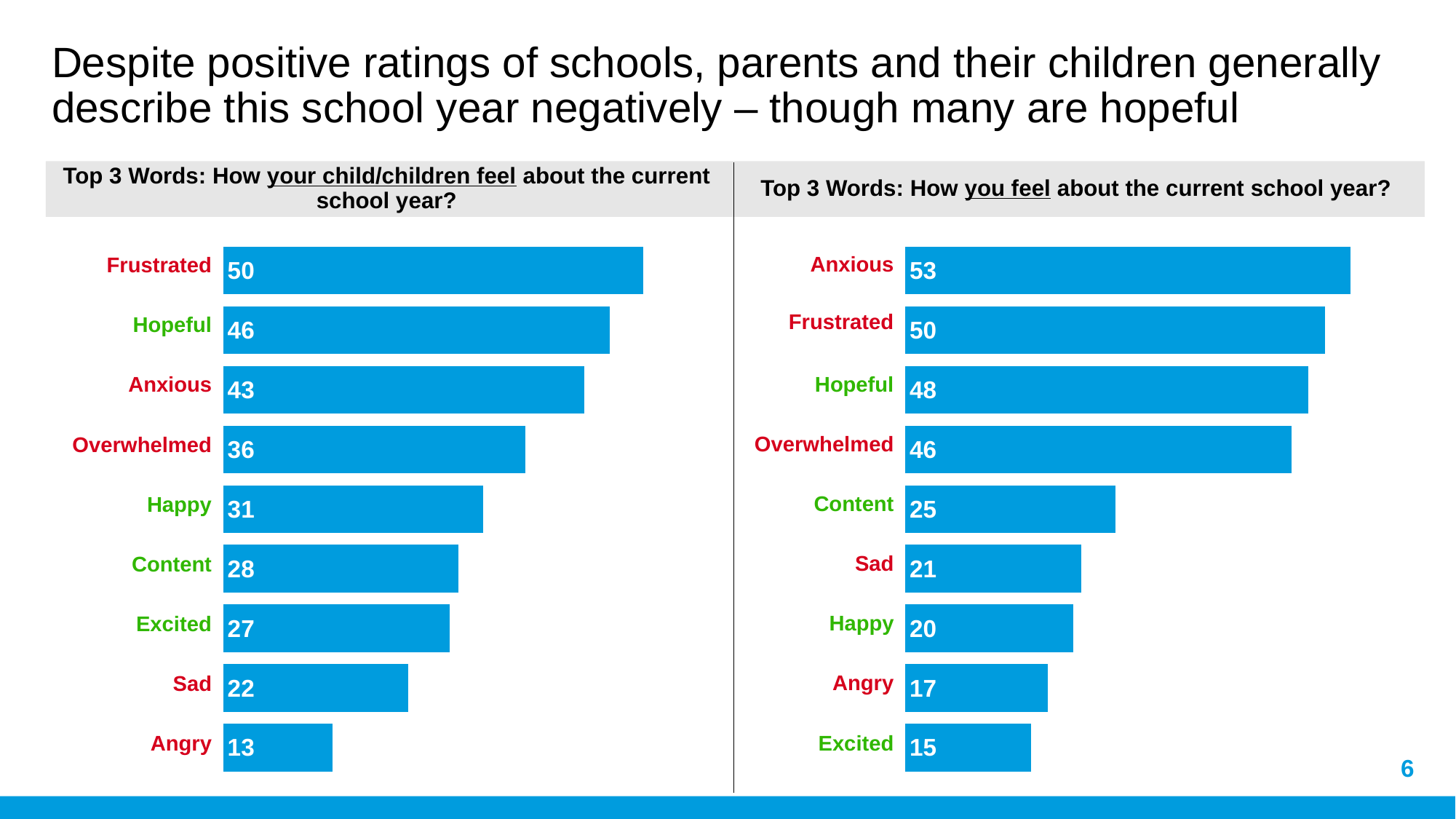
In the left chart (how your child/children feel about the current school year), what is the value for Frustrated? 50 What is the title of the right chart? Top 3 Words: How you feel about the current school year? In the left chart (how your child/children feel), what is the difference between the values for Hopeful and Sad? 24 In the left chart (how your child/children feel), which word has the highest value? Frustrated In the right chart (how you feel), which word has the lowest value? Excited What kind of chart is used in the right chart (how you feel about the current school year)? Bar chart In the left chart (how your child/children feel), what is the value for Angry? 13 In the right chart (how you feel about the current school year), what is the value for Overwhelmed? 46 In the right chart (how you feel), what is the difference between the values for Anxious and Hopeful? 5 How many words (categories) are shown in the left chart (how your child/children feel)? 9 In the left chart (how your child/children feel), which is larger, the value for Happy or the value for Content? Happy In the right chart (how you feel), which is larger, the value for Sad or the value for Angry? Sad